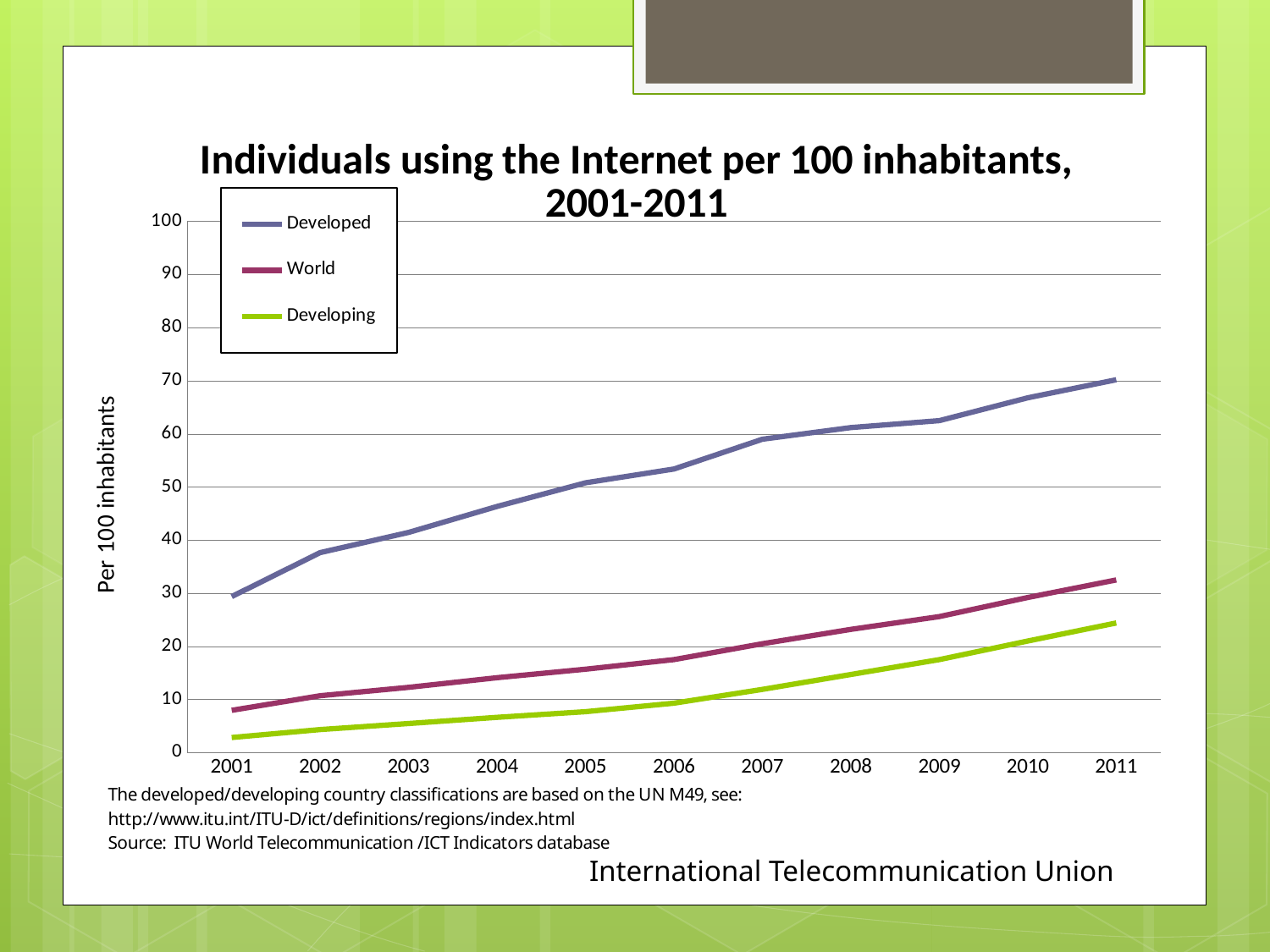
Which series has the highest values throughout the chart? Developed How many years are plotted along the x axis? 11 Is the value for Developing in 2001 greater or less than 10? less What kind of chart is shown on the slide? line chart Is the value for Developed in 2006 greater or less than 50? greater In 2011, which is larger: the value for World or the value for Developing? World Is the value for World in 2006 greater or less than 20? less What is the label of the y axis? Per 100 inhabitants Which series has the lowest values throughout the chart? Developing How many series does the legend list? 3 Does the Developed series rise or fall from 2001 to 2011? rise